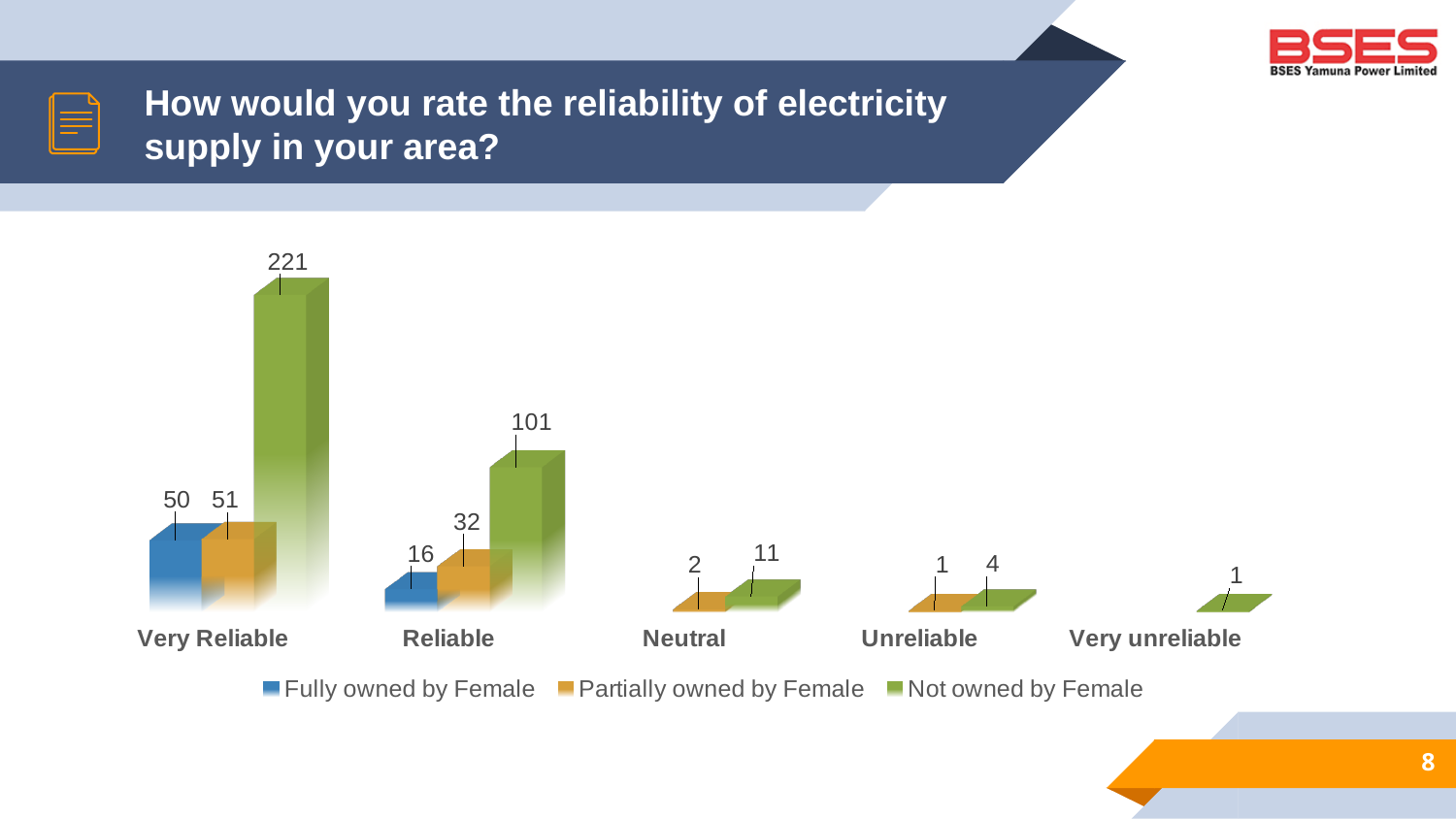
What is the difference between the Not owned by Female values for Very Reliable and Reliable? 120 What is the value for Partially owned by Female in the Very Reliable category? 51 What is the value for Fully owned by Female in the Reliable category? 16 What kind of chart is shown on the slide? Bar chart Which category has the highest value for Not owned by Female? Very Reliable Do the Not owned by Female values rise or fall from Very Reliable to Very unreliable? Fall What is the value for Not owned by Female in the Very Reliable category? 221 Which category has the lowest value for Not owned by Female? Very unreliable How many series does the legend list? 3 What is the value for Not owned by Female in the Neutral category? 11 In the Reliable category, which is larger: Partially owned by Female or Fully owned by Female? Partially owned by Female How many categories are shown on the x axis? 5